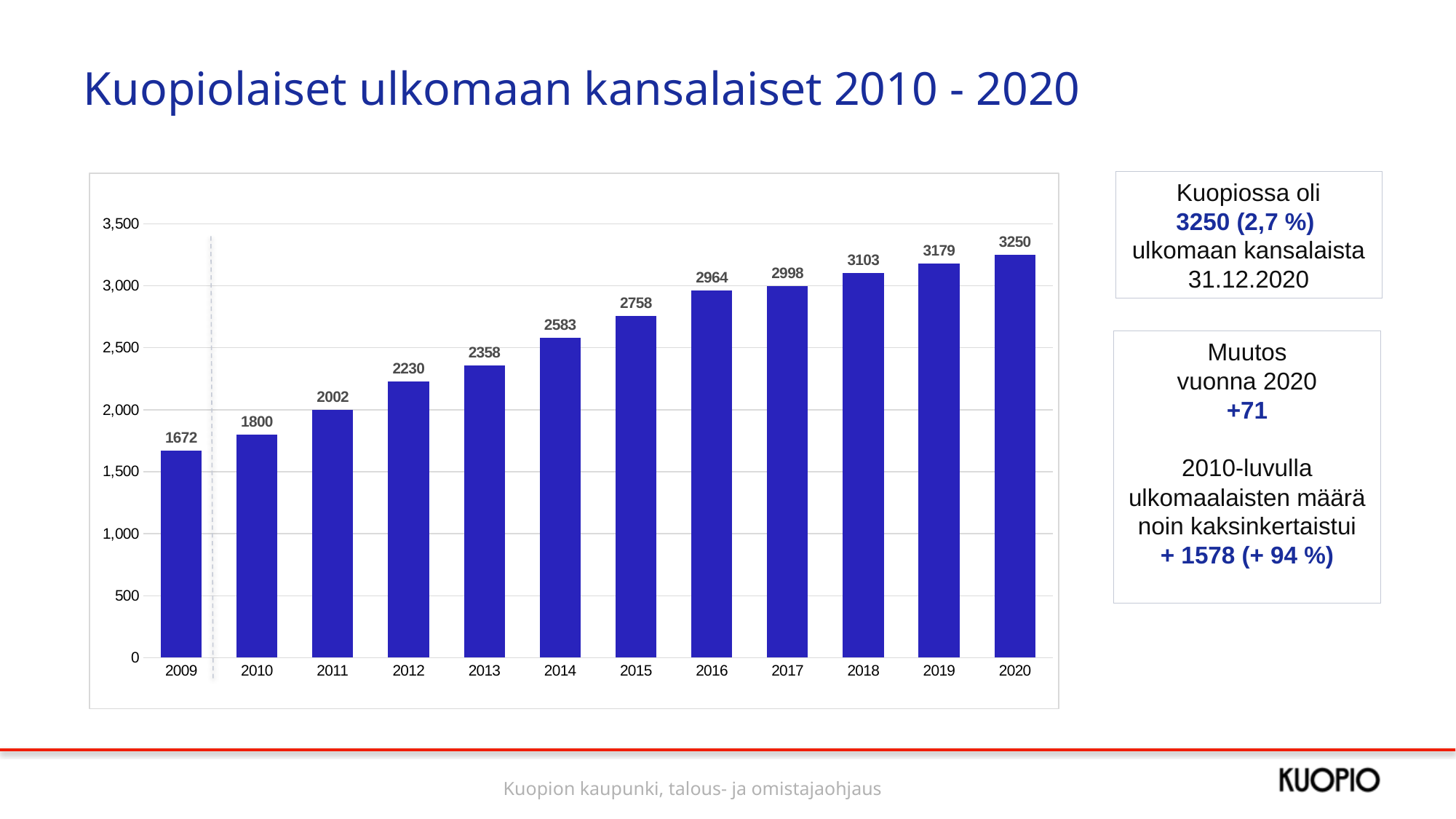
What is the difference between the values for 2020 and 2019? 71 What is the value for 2009? 1672 What kind of chart is shown on the slide? bar chart Which year has the highest value? 2020 Which is larger, the value for 2012 or the value for 2016? 2016 Which year has the lowest value? 2009 Is the value for 2011 greater or less than 2,500? less What is the difference between the values for 2014 and 2013? 225 What is the value for 2018? 3103 What is the value for 2015? 2758 How many years are shown on the x axis? 12 Do the values rise or fall from 2009 to 2020? rise